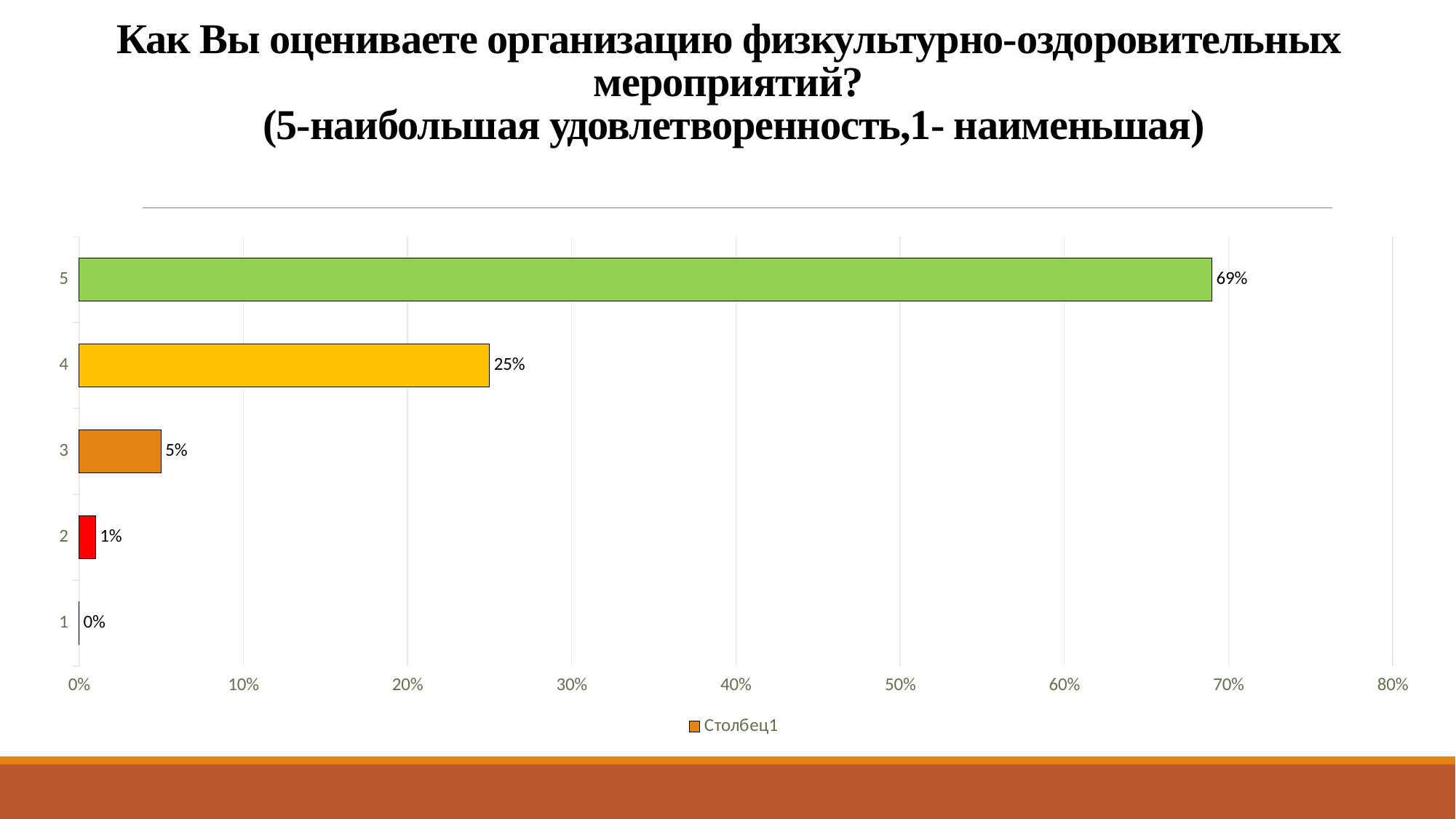
Which rating has the highest value? 5 What is the value for rating 1? 0% What is the value for rating 2? 1% What is the value for rating 4? 25% Which is larger, the value for rating 3 or the value for rating 2? rating 3 What is the legend entry shown below the chart? Столбец1 What kind of chart is shown on the slide? bar chart What is the difference between the values for rating 5 and rating 4? 44% What is the value for rating 3? 5% How many rating categories are shown on the chart? 5 What is the value for rating 5? 69% Which rating has the lowest value? 1